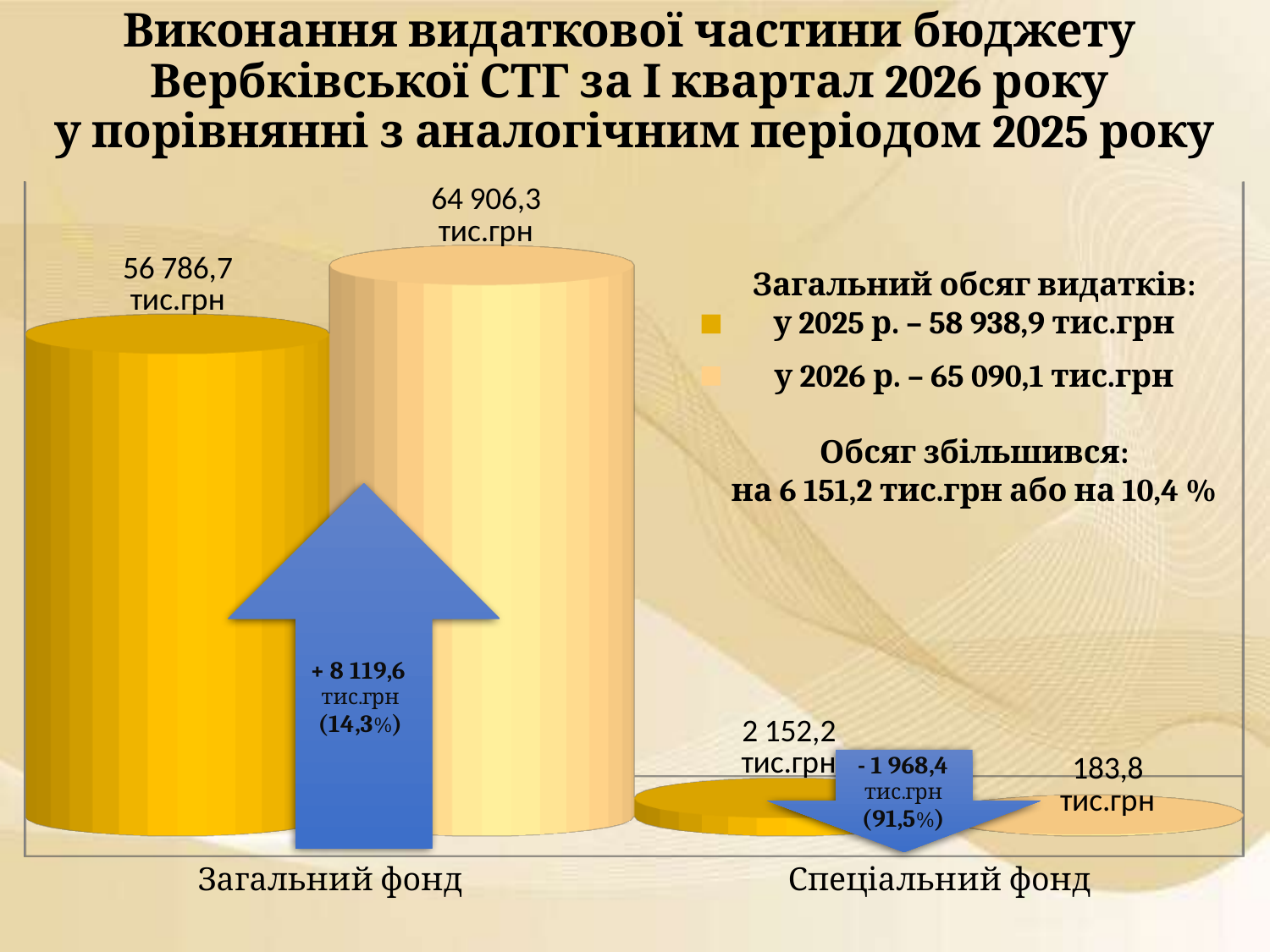
What kind of chart is shown on the slide? Bar chart How many series does the legend list? 2 What is the value for Спеціальний фонд in 2026? 183,8 тис.грн For Спеціальний фонд, which year has the larger value, 2025 or 2026? 2025 By how much did Загальний фонд increase from 2025 to 2026, according to the label on the arrow? + 8 119,6 тис.грн (14,3%) What is the value for Спеціальний фонд in 2025? 2 152,2 тис.грн By how much did Спеціальний фонд decrease from 2025 to 2026, according to the label on the arrow? - 1 968,4 тис.грн (91,5%) Which bar has the lowest value on the chart? Спеціальний фонд, 2026 What is the value for Загальний фонд in 2026 (the lighter yellow bar)? 64 906,3 тис.грн Which bar has the highest value on the chart? Загальний фонд, 2026 How many categories are shown on the x axis of the chart? 2 What is the value for Загальний фонд in 2025 (the darker yellow bar)? 56 786,7 тис.грн